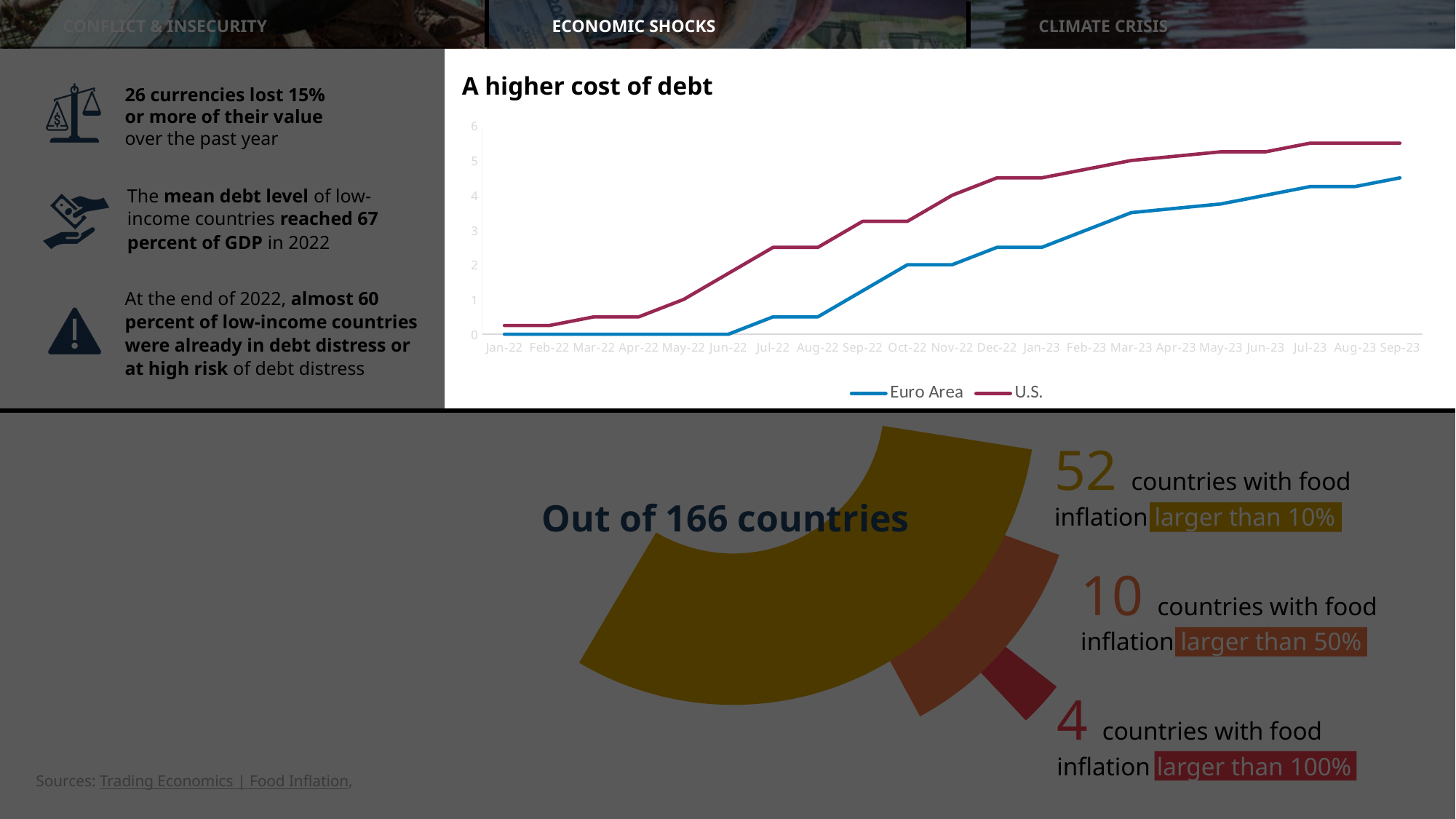
How many months are shown on the x axis of 'A higher cost of debt'? 21 What is the title of the line chart on the slide? A higher cost of debt In 'A higher cost of debt', which series is drawn in blue? Euro Area In 'A higher cost of debt', is the Euro Area value at Jun-22 greater or less than 1? less In 'A higher cost of debt', is the Euro Area value at Sep-23 greater or less than 4? greater What kind of chart is 'A higher cost of debt'? line chart In 'A higher cost of debt', is the U.S. value at Jan-22 greater or less than 1? less In 'A higher cost of debt', do the values for the U.S. rise or fall from Jan-22 to Sep-23? rise How many series does the legend of 'A higher cost of debt' list? 2 In 'A higher cost of debt', which series is higher at Sep-23, Euro Area or U.S.? U.S.